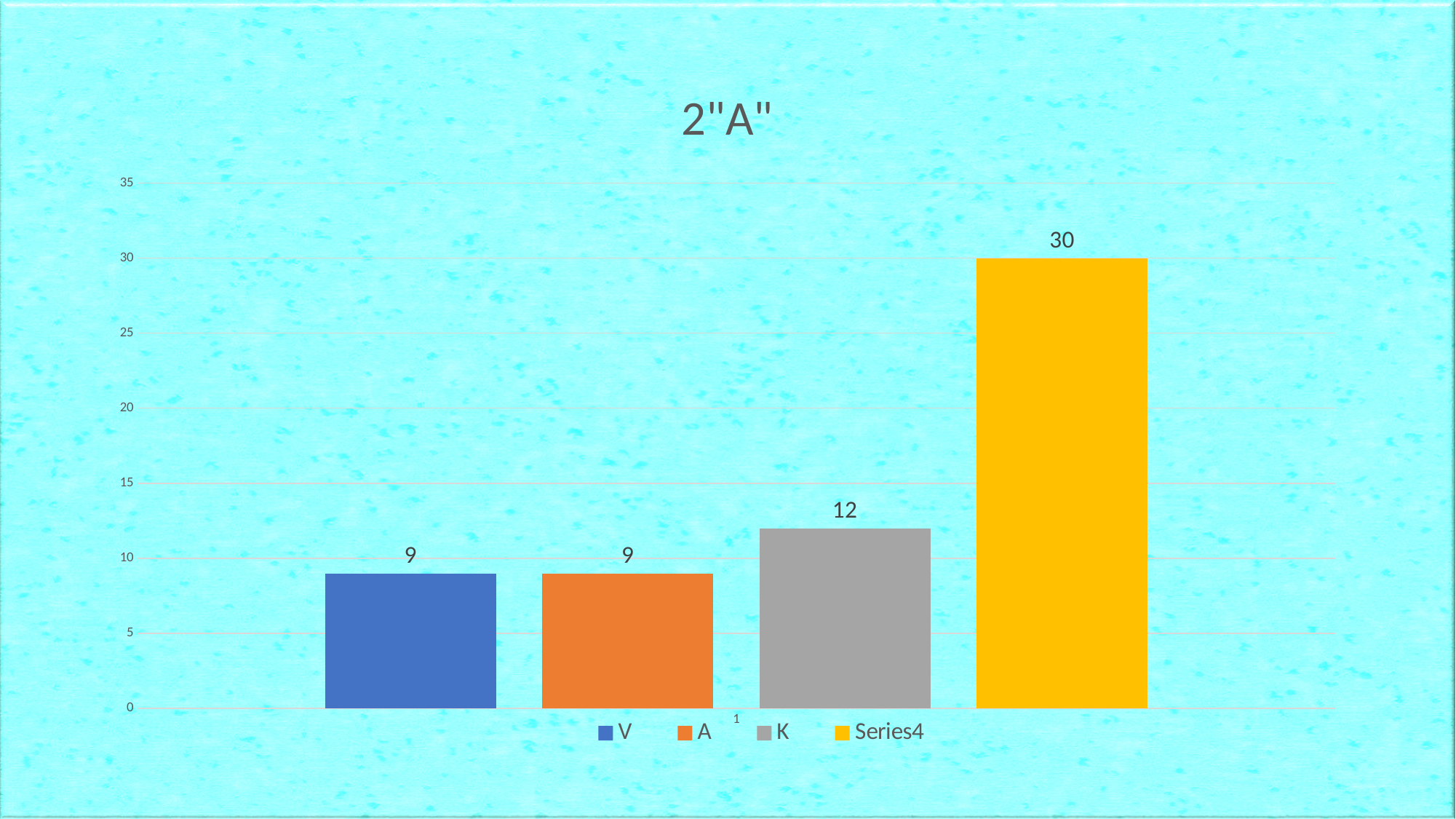
Which is larger, the value for K or the value for A? K What is the difference between the values for K and V? 3 What is the value for series V? 9 What is the value for series A? 9 Which series has the highest value? Series4 What is the title of the chart? 2"A" What is the difference between the values for Series4 and K? 18 What colour is the bar for Series4? yellow What is the value for Series4? 30 How many series does the legend list? 4 What is the value for series K? 12 What kind of chart is shown on the slide? bar chart